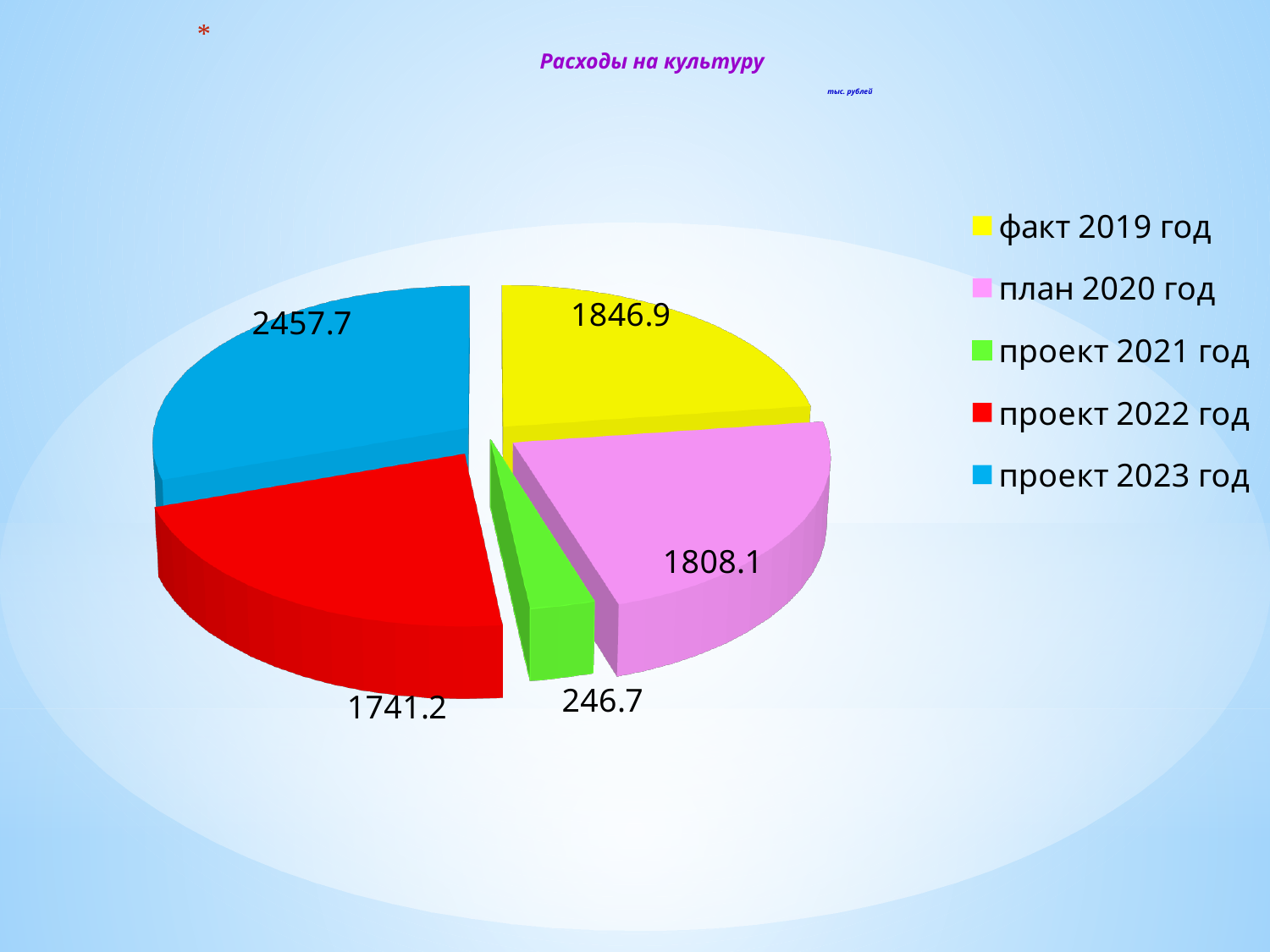
What is the value for факт 2019 год? 1846.9 What is the value for план 2020 год? 1808.1 What is the value for проект 2023 год? 2457.7 What is the value for проект 2022 год? 1741.2 What is the difference between the values for проект 2023 год and факт 2019 год? 610.8 What type of chart is shown on the slide? pie chart What is the title of the chart? Расходы на культуру How many entries does the legend list? 5 What is the value for проект 2021 год? 246.7 Which category has the smallest slice of the pie? проект 2021 год Which category has the largest slice of the pie? проект 2023 год Which is larger, the value for факт 2019 год or the value for план 2020 год? факт 2019 год